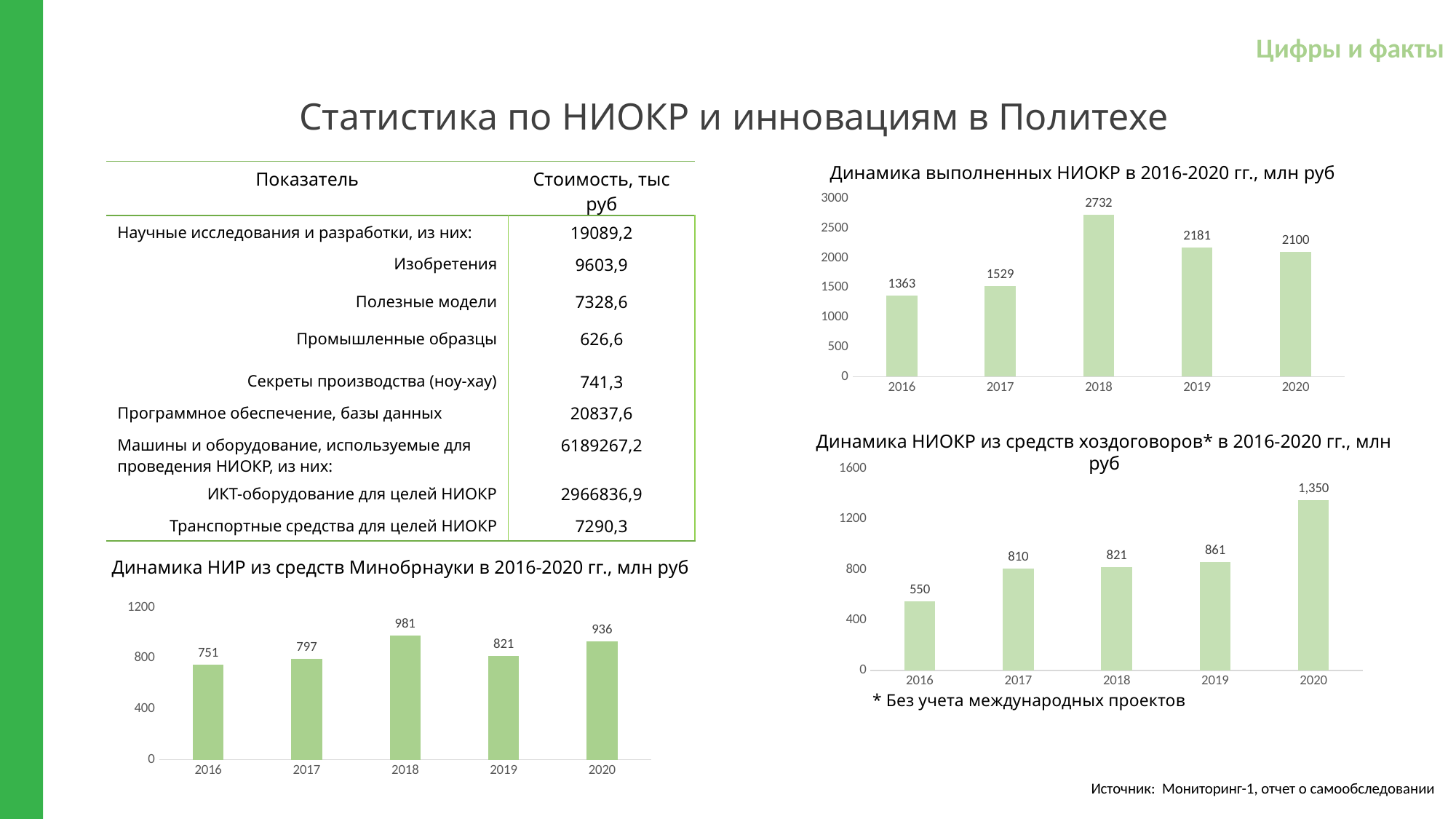
In the chart 'Динамика НИОКР из средств хоздоговоров* в 2016-2020 гг., млн руб', do the values rise or fall from 2016 to 2020? rise In the chart 'Динамика НИОКР из средств хоздоговоров* в 2016-2020 гг., млн руб', which is larger, the value for 2016 or the value for 2019? 2019 In the chart 'Динамика выполненных НИОКР в 2016-2020 гг., млн руб', what is the value for 2018? 2732 In the chart 'Динамика НИР из средств Минобрнауки в 2016-2020 гг., млн руб', is the value for 2017 greater or less than 800? less In the chart 'Динамика выполненных НИОКР в 2016-2020 гг., млн руб', what is the difference between the 2018 and 2019 values? 551 In the chart 'Динамика НИР из средств Минобрнауки в 2016-2020 гг., млн руб', what is the difference between the 2020 and 2016 values? 185 In the chart 'Динамика НИР из средств Минобрнауки в 2016-2020 гг., млн руб', what is the value for 2020? 936 In the chart 'Динамика НИР из средств Минобрнауки в 2016-2020 гг., млн руб', which year has the highest value? 2018 In the chart 'Динамика выполненных НИОКР в 2016-2020 гг., млн руб', how many years are plotted? 5 In the chart 'Динамика НИОКР из средств хоздоговоров* в 2016-2020 гг., млн руб', what is the value for 2020? 1,350 What type of chart is 'Динамика НИОКР из средств хоздоговоров* в 2016-2020 гг., млн руб'? bar chart In the chart 'Динамика выполненных НИОКР в 2016-2020 гг., млн руб', which year has the lowest value? 2016